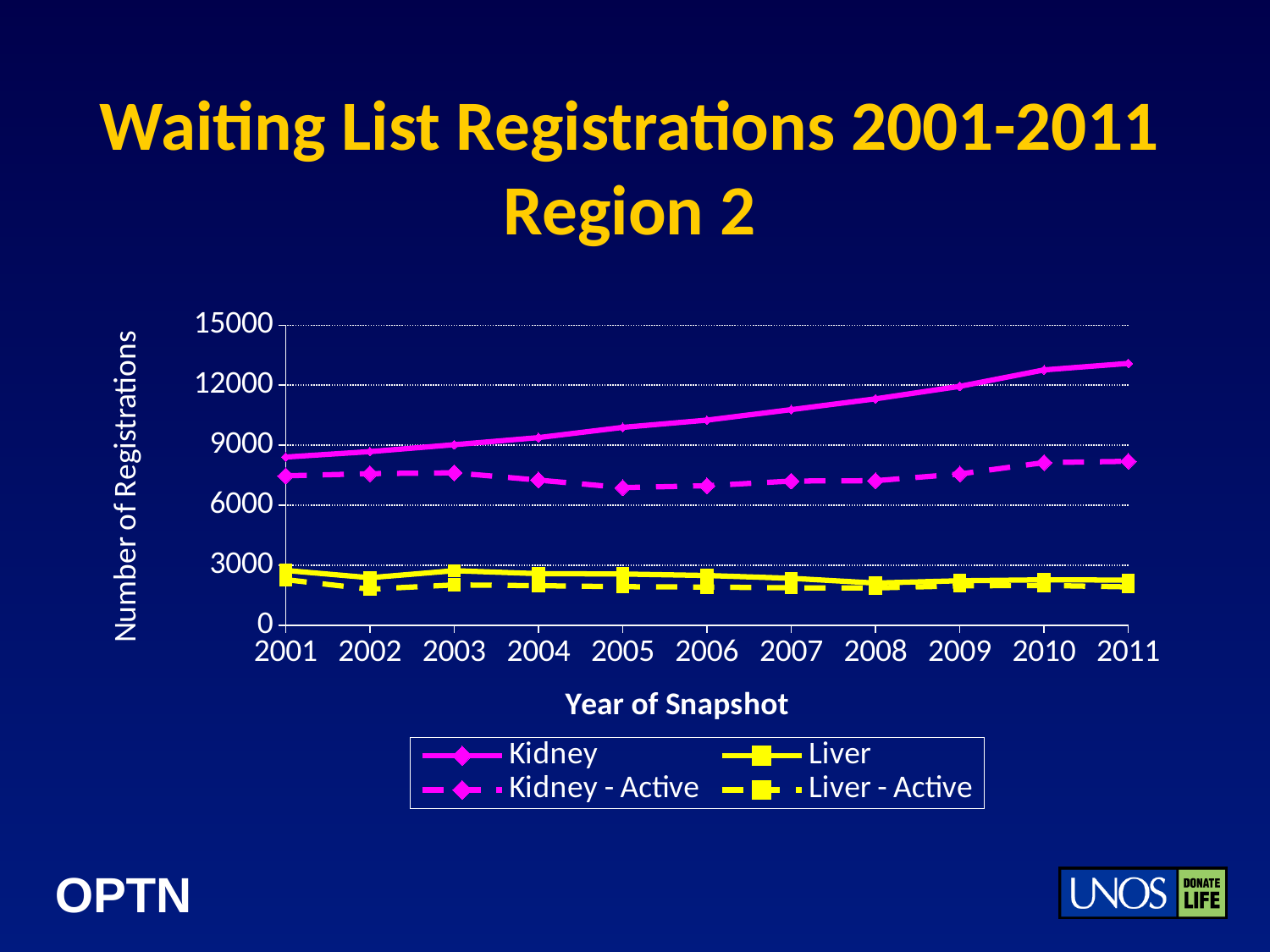
What is the title of the chart's x axis? Year of Snapshot Does the Kidney series rise or fall from 2001 to 2011? Rise What kind of chart is shown on the slide? Line chart How many series does the legend list? 4 Which series has the highest values across the chart? Kidney How many years are plotted along the x axis? 11 Is the Kidney - Active value for 2005 greater or less than 6000? greater Is the Kidney value for 2001 greater or less than 9000? less Is the Liver value for 2001 greater or less than 3000? less What is the title of the chart's y axis? Number of Registrations In 2011, which is larger: the Kidney value or the Liver value? Kidney